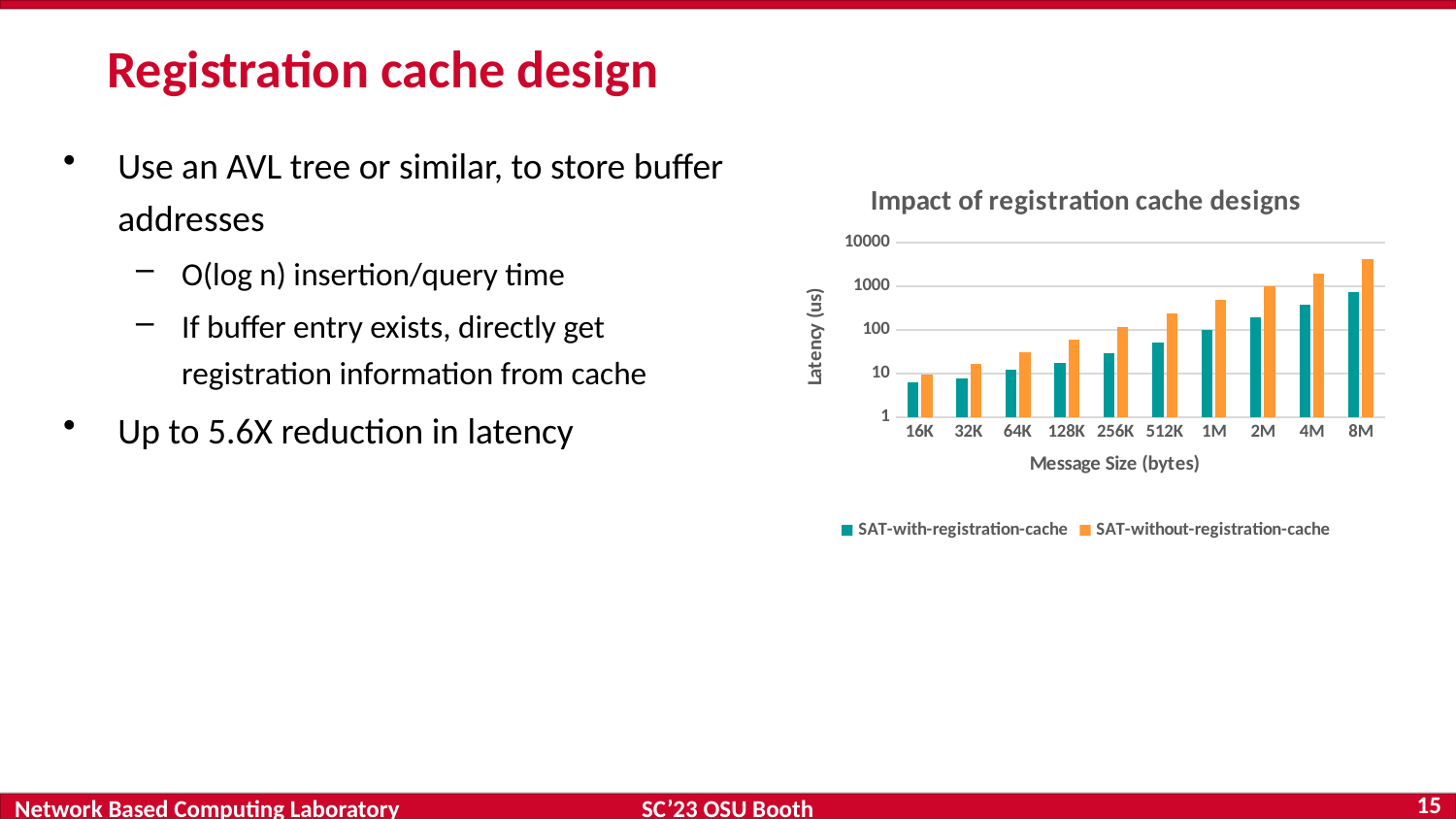
What is the label of the y axis of the chart? Latency (us) Which message size has the lowest latency for SAT-with-registration-cache? 16K Is the latency for SAT-with-registration-cache at 8M greater or less than 1000? less How many series does the chart legend list? 2 What type of chart is shown on the slide? bar chart Which message size has the highest latency for SAT-without-registration-cache? 8M Do the latency values for SAT-with-registration-cache rise or fall as message size increases along the x axis? rise Is the latency for SAT-without-registration-cache at 8M greater or less than 1000? greater What is the title of the chart? Impact of registration cache designs At message size 8M, which series has the higher latency, SAT-with-registration-cache or SAT-without-registration-cache? SAT-without-registration-cache How many message sizes are shown on the x axis of the chart? 10 Is the latency for SAT-with-registration-cache at 16K greater or less than 10? less